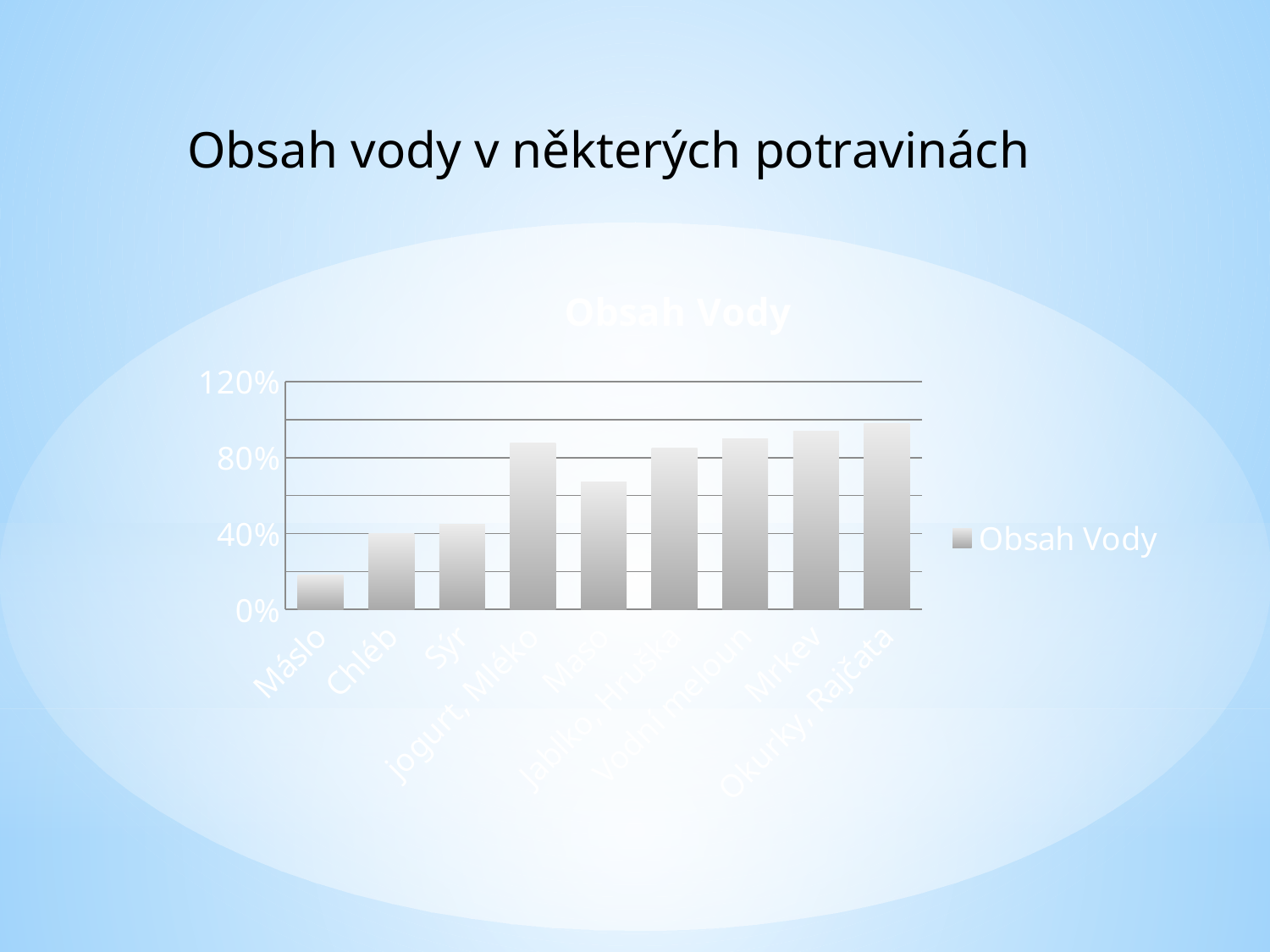
Is the value for Maso greater or less than 80%? less Is the value for Jogurt, Mléko greater or less than 80%? greater Which is larger, the value for Maso or the value for Jogurt, Mléko? Jogurt, Mléko Which is larger, the value for Máslo or the value for Chléb? Chléb Which category has the highest value? Okurky, Rajčata How many series does the legend list? 1 How many categories are plotted on the x axis? 9 What is the title of the chart? Obsah Vody Is the value for Máslo greater or less than 40%? less Which category has the lowest value? Máslo What kind of chart is shown on the slide? bar chart